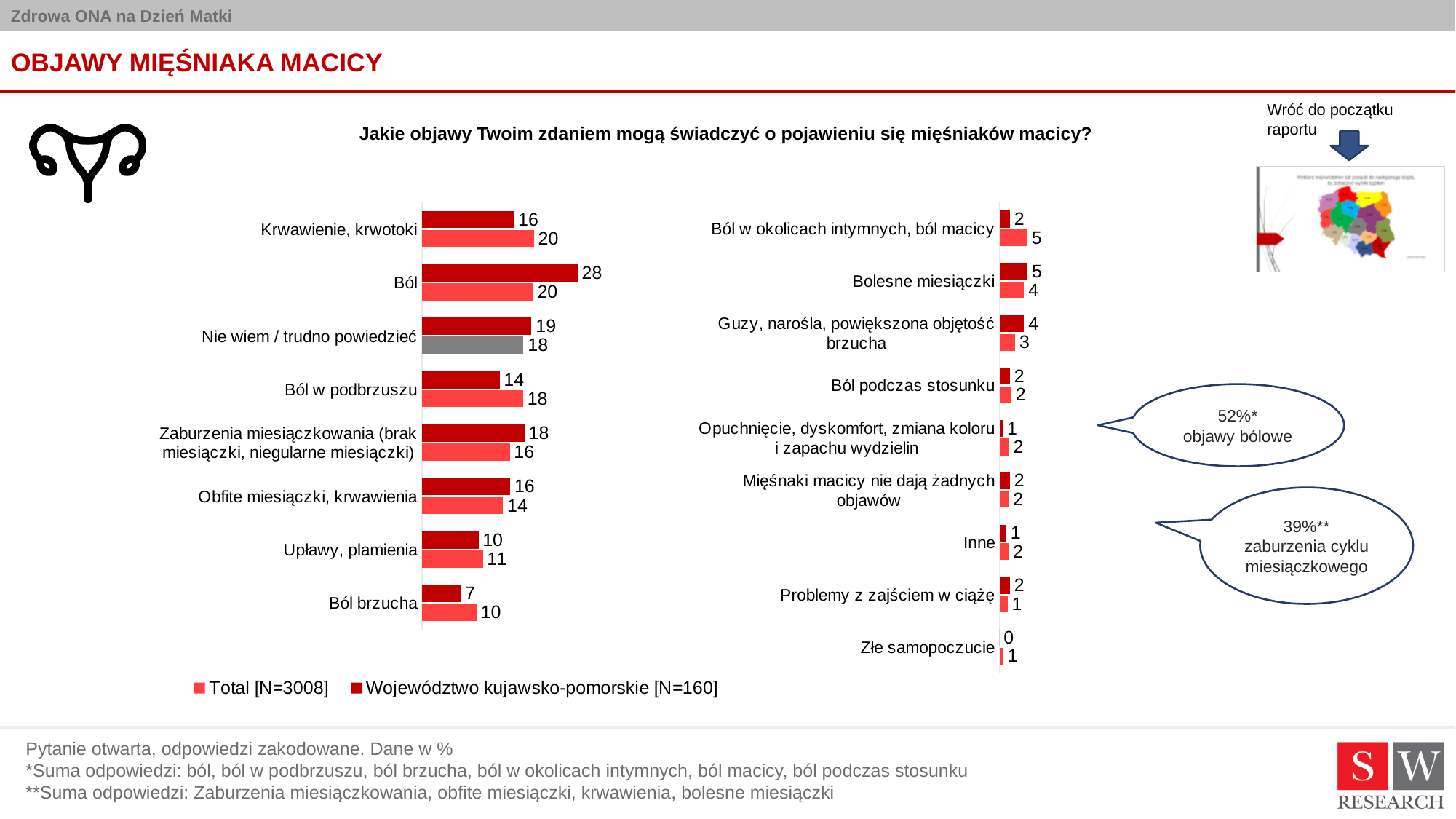
On the left chart, what is the difference between the Województwo kujawsko-pomorskie and Total values for Ból? 8 On the left chart, which category has the lowest Total [N=3008] value? Ból brzucha On the right chart, what is the Województwo kujawsko-pomorskie [N=160] value for Bolesne miesiączki? 5 How many categories does the right chart show? 9 On the left chart, what is the Total [N=3008] value for Krwawienie, krwotoki? 20 On the right chart, what is the Województwo kujawsko-pomorskie [N=160] value for Złe samopoczucie? 0 On the left chart, what is the value for Ból for Województwo kujawsko-pomorskie [N=160]? 28 What type of chart is used on the left side of the slide? Bar chart On the left chart, which category has the highest value for Województwo kujawsko-pomorskie [N=160]? Ból On the right chart, what is the Total [N=3008] value for Ból w okolicach intymnych, ból macicy? 5 How many series does the legend list? 2 On the left chart, which is larger for Ból w podbrzuszu: the Total value or the Województwo kujawsko-pomorskie value? Total